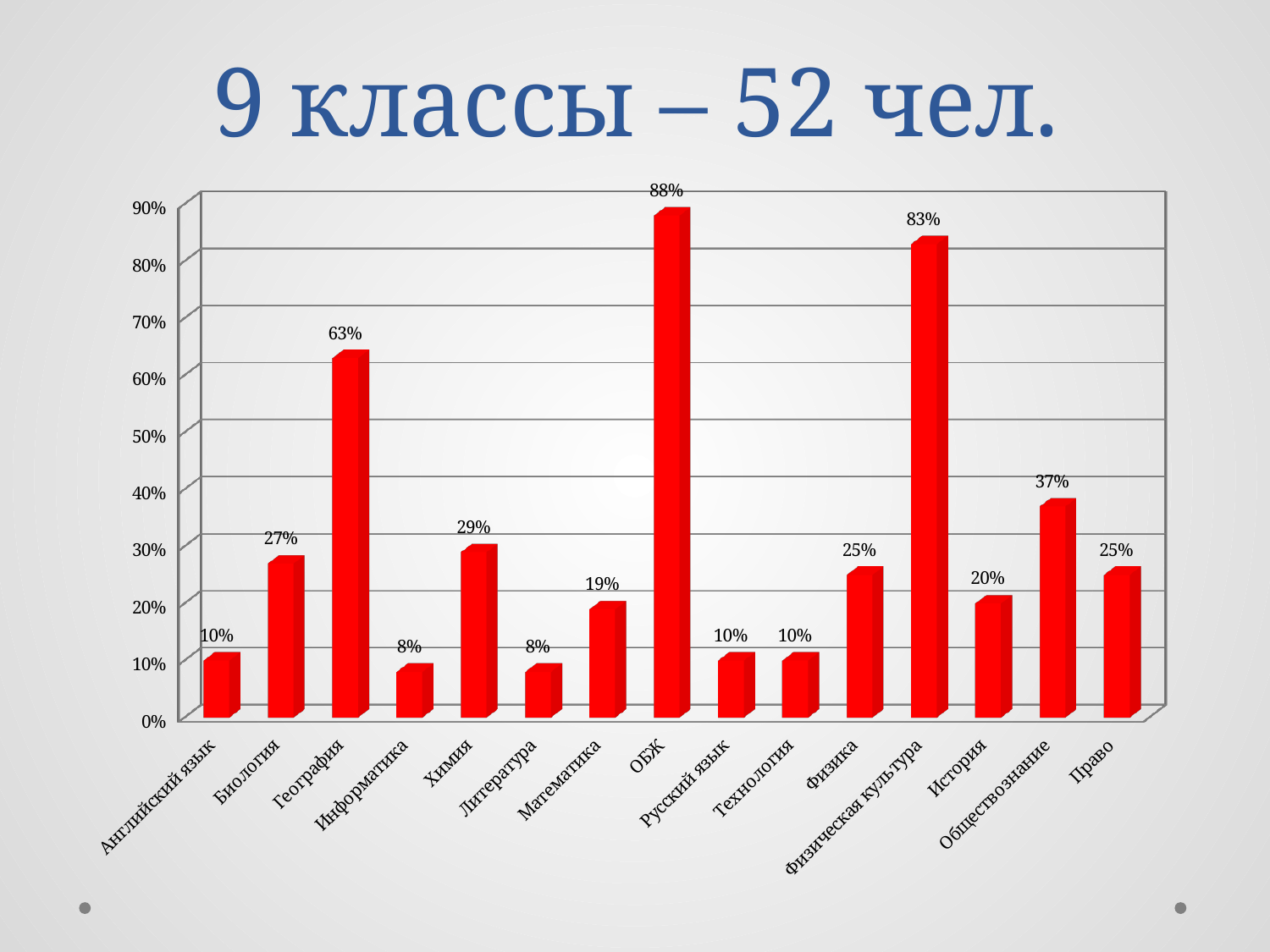
What kind of chart is shown on the slide? bar chart Which is larger, the value for Химия or the value for Биология? Химия Which category has the highest value? ОБЖ Is the value for Математика greater or less than 20%? less What is the difference between the values for ОБЖ and Физическая культура? 5% What is the title of the slide? 9 классы – 52 чел. How many categories are shown on the x axis? 15 What is the difference between the values for География and Обществознание? 26% What is the value for Физическая культура? 83% What colour are the bars in the chart? red What is the value for Обществознание? 37% What is the value for География? 63%